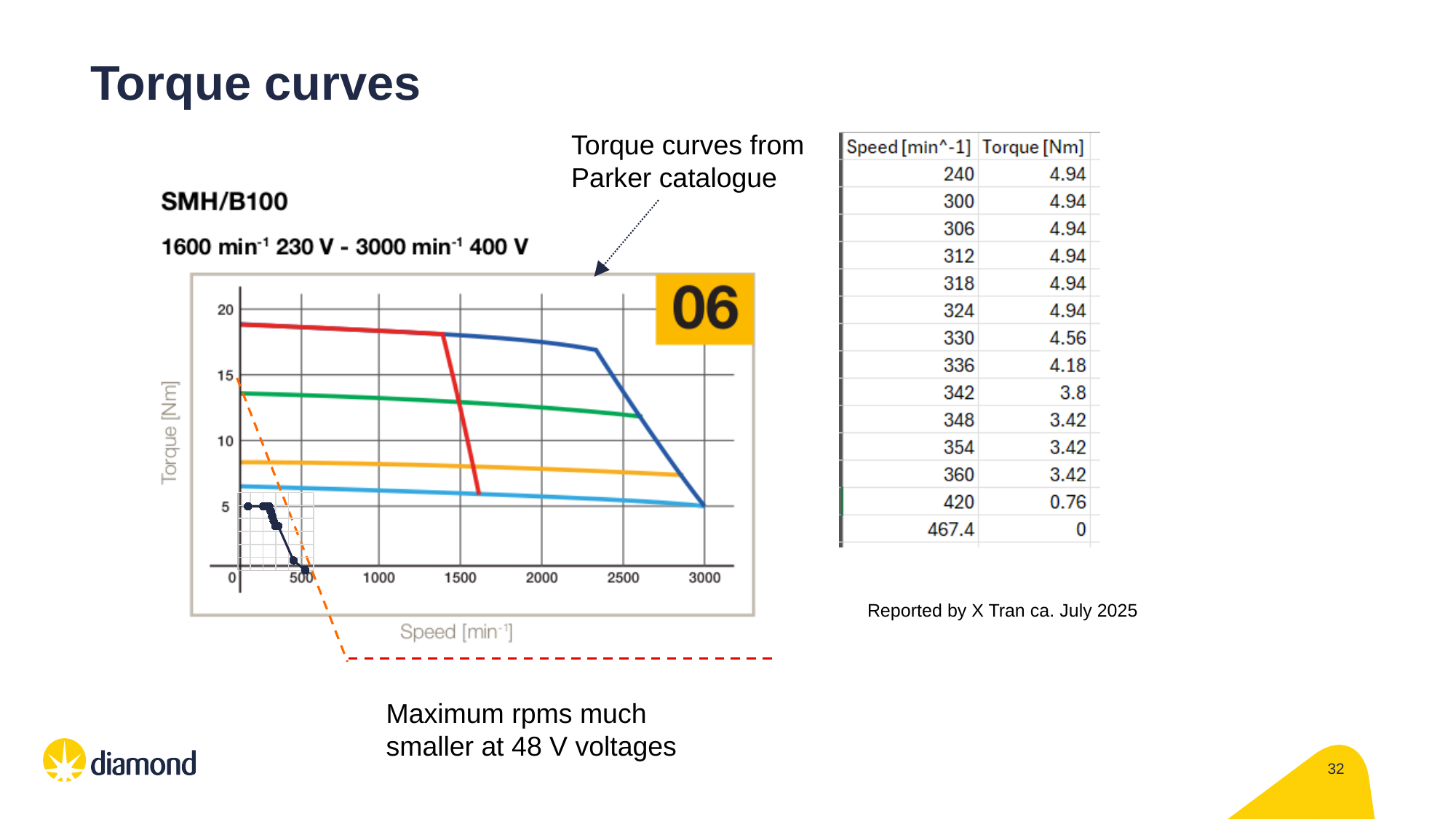
What is the highest torque value listed in the table? 4.94 What is the difference between the torque at 330 min^-1 and the torque at 336 min^-1 in the table? 0.38 According to the table, at what speed does the torque reach 0 Nm? 467.4 According to the table, what is the torque at a speed of 420 min^-1? 0.76 Is the torque of the red curve at a speed of 1000 min^-1 greater or less than 15? greater Which has the larger torque in the table: speed 330 min^-1 or speed 348 min^-1? 330 min^-1 In the table, does torque rise or fall as speed increases? fall What kind of chart is shown on the slide? line chart What is the label of the x axis of the chart? Speed [min⁻¹] How many speed/torque rows are listed in the table? 14 According to the table, what is the torque at a speed of 240 min^-1? 4.94 What is the label of the y axis of the chart? Torque [Nm]